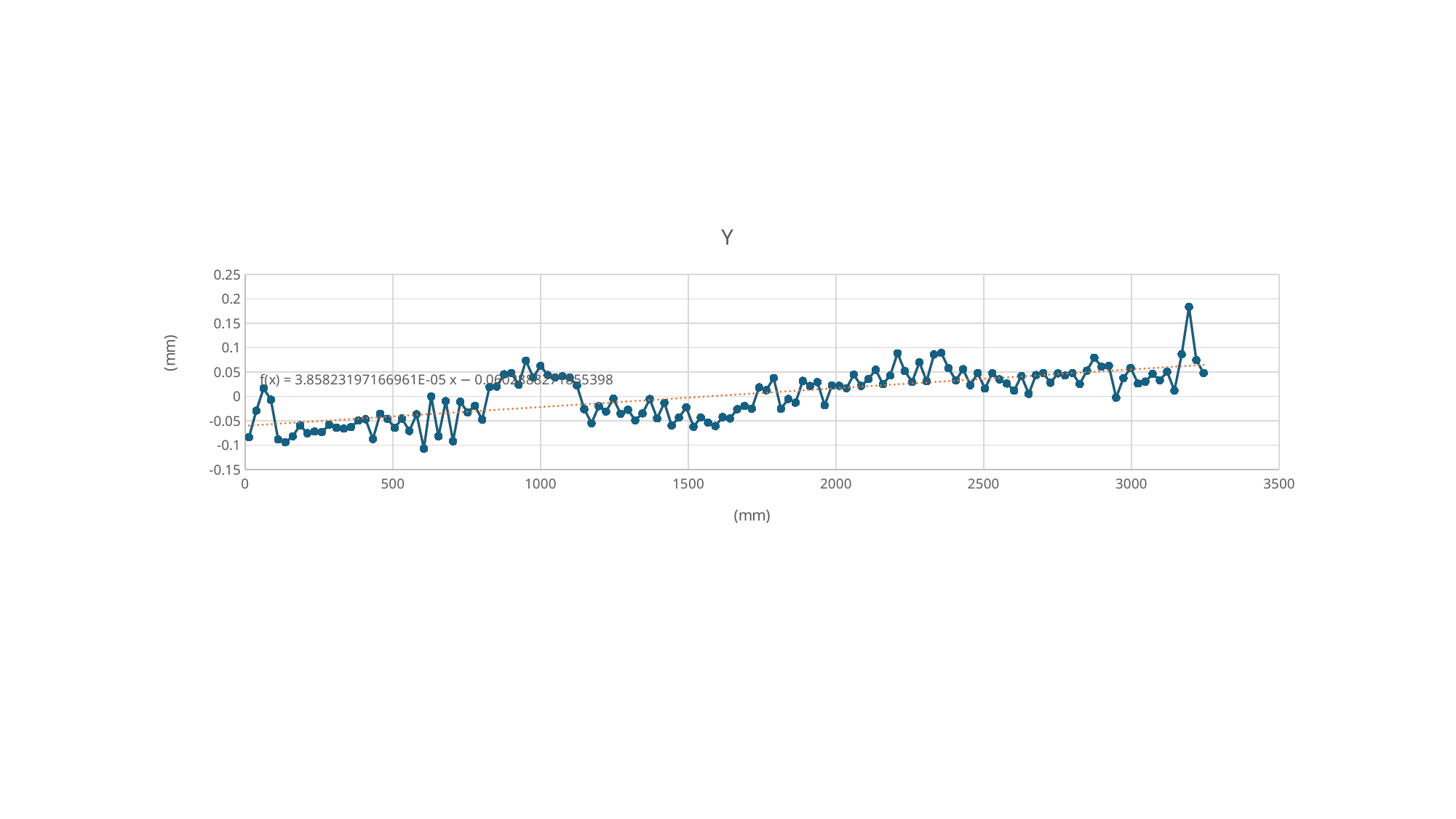
Does the dotted trendline slope upward or downward across the chart? upward What kind of chart is shown on the slide? line chart Is the first plotted value, at x = 0, greater or less than -0.05? less What is the title of the chart? Y What is the largest tick label shown on the x axis? 3500 Is the plotted value near x = 2200 greater or less than 0.05? greater Is the plotted value near x = 1500 greater or less than 0? less What is the lowest tick label shown on the y axis? -0.15 Overall, do the plotted values rise or fall as x increases from 0 to about 3250? rise